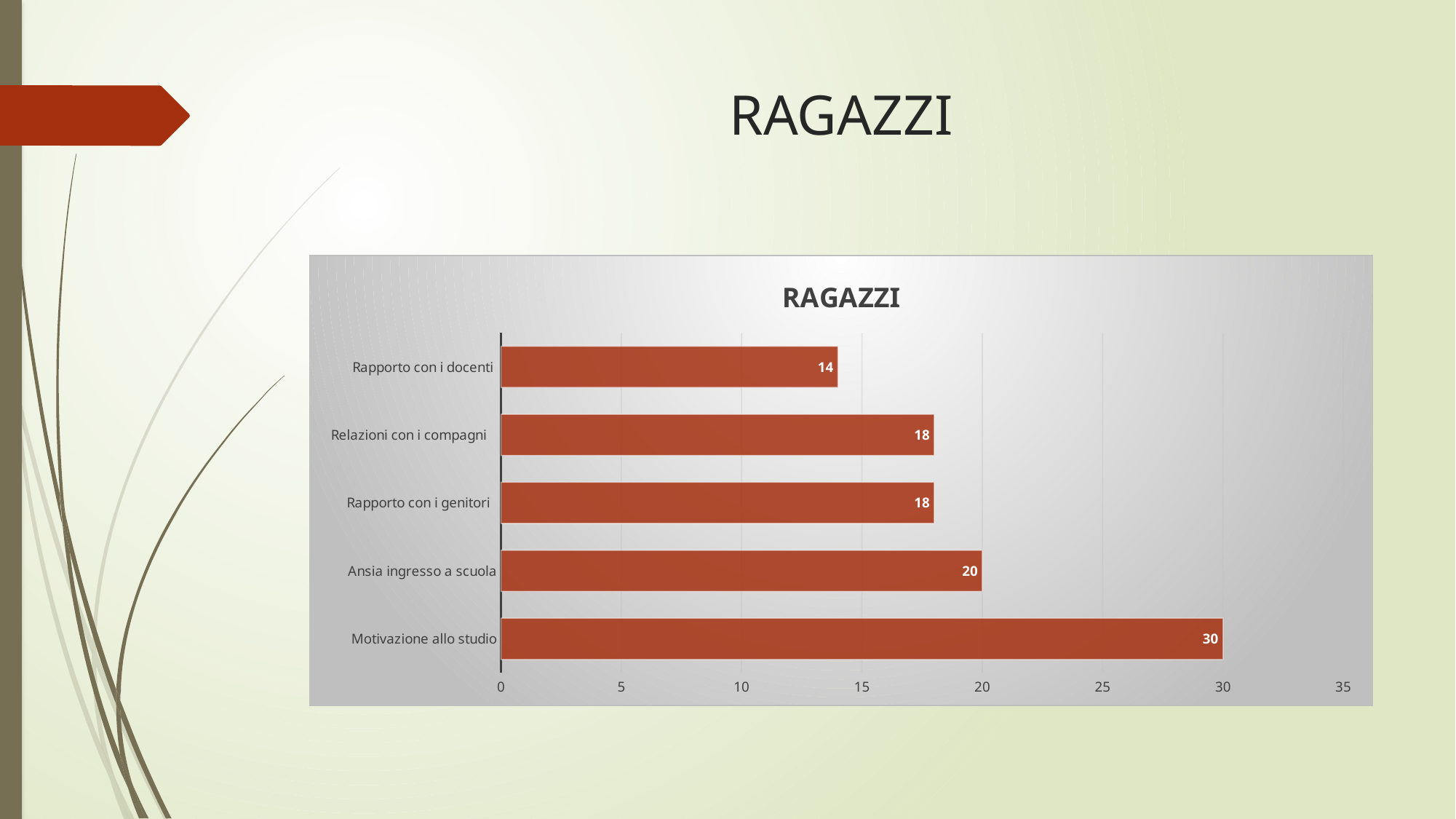
What is the value for Motivazione allo studio? 30 Which category has the highest value? Motivazione allo studio Which category has the lowest value? Rapporto con i docenti What is the value for Ansia ingresso a scuola? 20 Which is larger, the value for Ansia ingresso a scuola or the value for Rapporto con i genitori? Ansia ingresso a scuola What kind of chart is shown on the slide? Bar chart What is the difference between the values for Relazioni con i compagni and Rapporto con i docenti? 4 Is the value for Motivazione allo studio greater or less than 25? greater What is the difference between the values for Motivazione allo studio and Ansia ingresso a scuola? 10 What is the value for Rapporto con i docenti? 14 What is the title of the chart? RAGAZZI How many categories are shown in the chart? 5